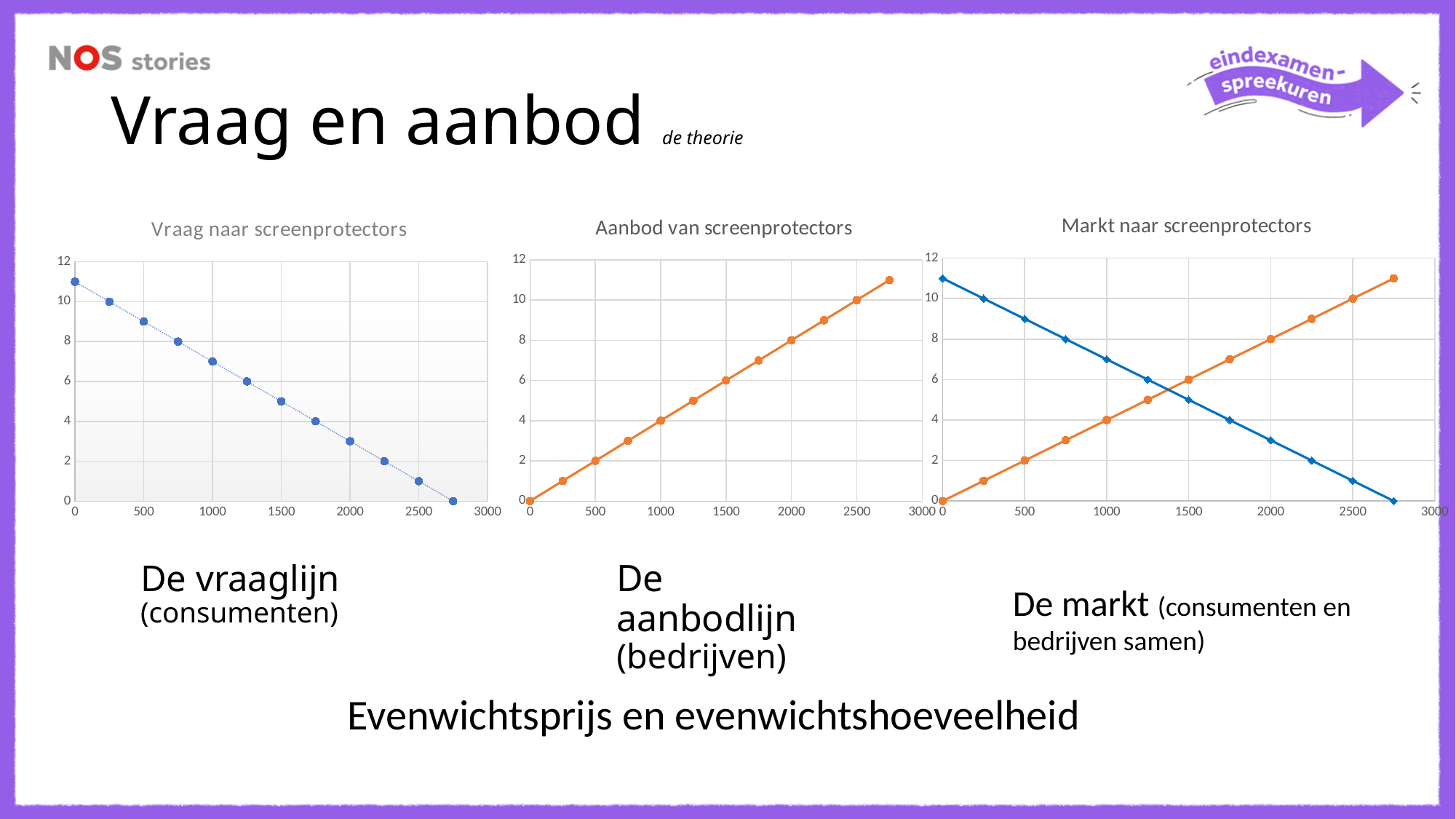
What is the title of the chart on the right of the slide? Markt naar screenprotectors How many data points are plotted in the chart titled 'Vraag naar screenprotectors'? 12 In the chart titled 'Aanbod van screenprotectors', do the values rise or fall as the x axis increases? rise In the chart titled 'Aanbod van screenprotectors', what is the value at x = 1000? 4 How many charts are shown on the slide? 3 In the chart titled 'Aanbod van screenprotectors', what is the value at x = 0? 0 In the chart titled 'Markt naar screenprotectors', which line is higher at x = 2500, the blue line or the orange line? the orange line In the chart titled 'Vraag naar screenprotectors', do the values rise or fall as the x axis increases? fall In the chart titled 'Vraag naar screenprotectors', is the value at x = 2000 greater or less than 4? less In the chart titled 'Markt naar screenprotectors', which line is higher at x = 500, the blue line or the orange line? the blue line In the chart titled 'Vraag naar screenprotectors', is the value at x = 500 greater or less than 8? greater In the chart titled 'Aanbod van screenprotectors', what is the value at x = 2500? 10